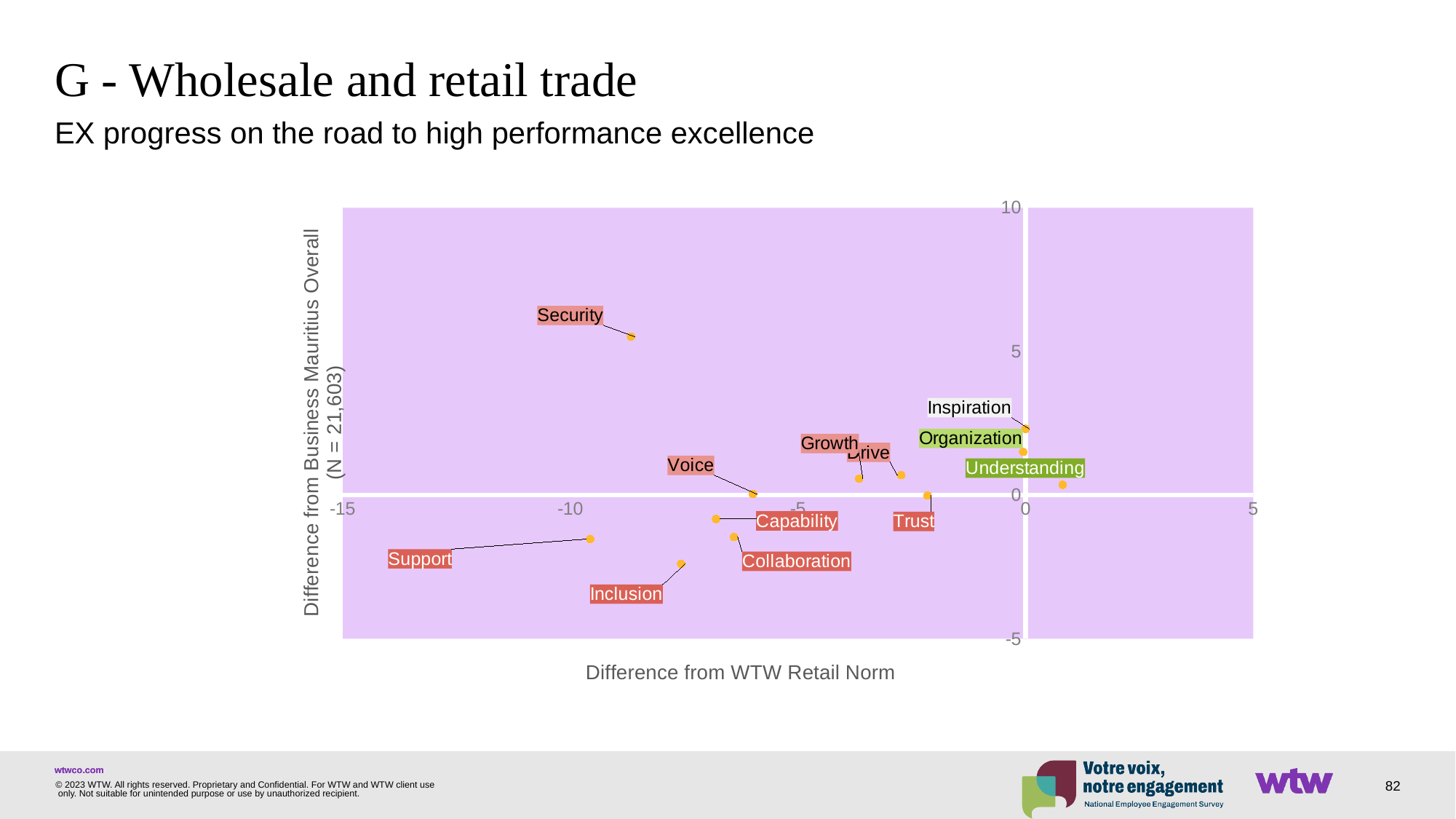
What kind of chart is shown on the slide? Scatter chart Which has the higher vertical-axis value, Security or Inspiration? Security What is the title of the horizontal axis of the chart? Difference from WTW Retail Norm Which has the larger horizontal-axis value (Difference from WTW Retail Norm), Support or Trust? Trust Is the vertical-axis value (Difference from Business Mauritius Overall) for Inclusion greater or less than 0? less Is the horizontal-axis value (Difference from WTW Retail Norm) for Security greater or less than -5? less Which labelled point is furthest to the left on the horizontal axis (Difference from WTW Retail Norm)? Support Which labelled point has the highest value on the vertical axis (Difference from Business Mauritius Overall)? Security How many labelled data points are plotted on the chart? 12 Is the vertical-axis value (Difference from Business Mauritius Overall) for Inspiration greater or less than 0? greater Which labelled point has the lowest value on the vertical axis (Difference from Business Mauritius Overall)? Inclusion Which labelled point is furthest to the right on the horizontal axis (Difference from WTW Retail Norm)? Understanding